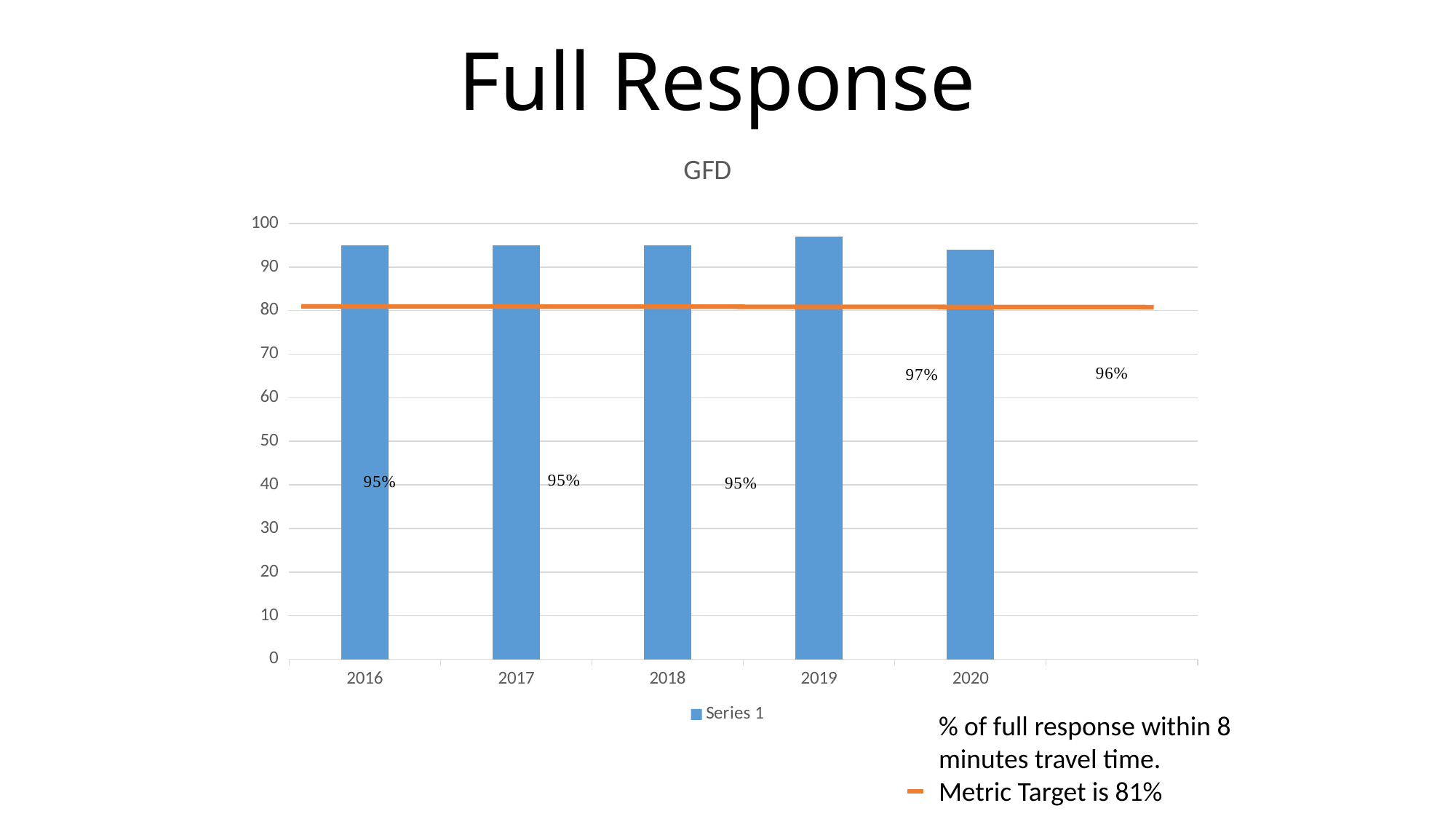
What type of chart is shown on the slide? bar chart What is the value for 2019? 97% Which is larger, the value for 2019 or the value for 2017? 2019 Which year has the highest value? 2019 What is the value for 2016? 95% What is the value for 2018? 95% How many years are plotted on the x axis of the chart? 5 Is the value for 2020 greater or less than 90? greater What metric target does the orange line on the chart represent? 81% How many series does the chart legend list? 1 What is the difference between the value for 2019 and the value for 2016? 2% What is the title of the chart? GFD